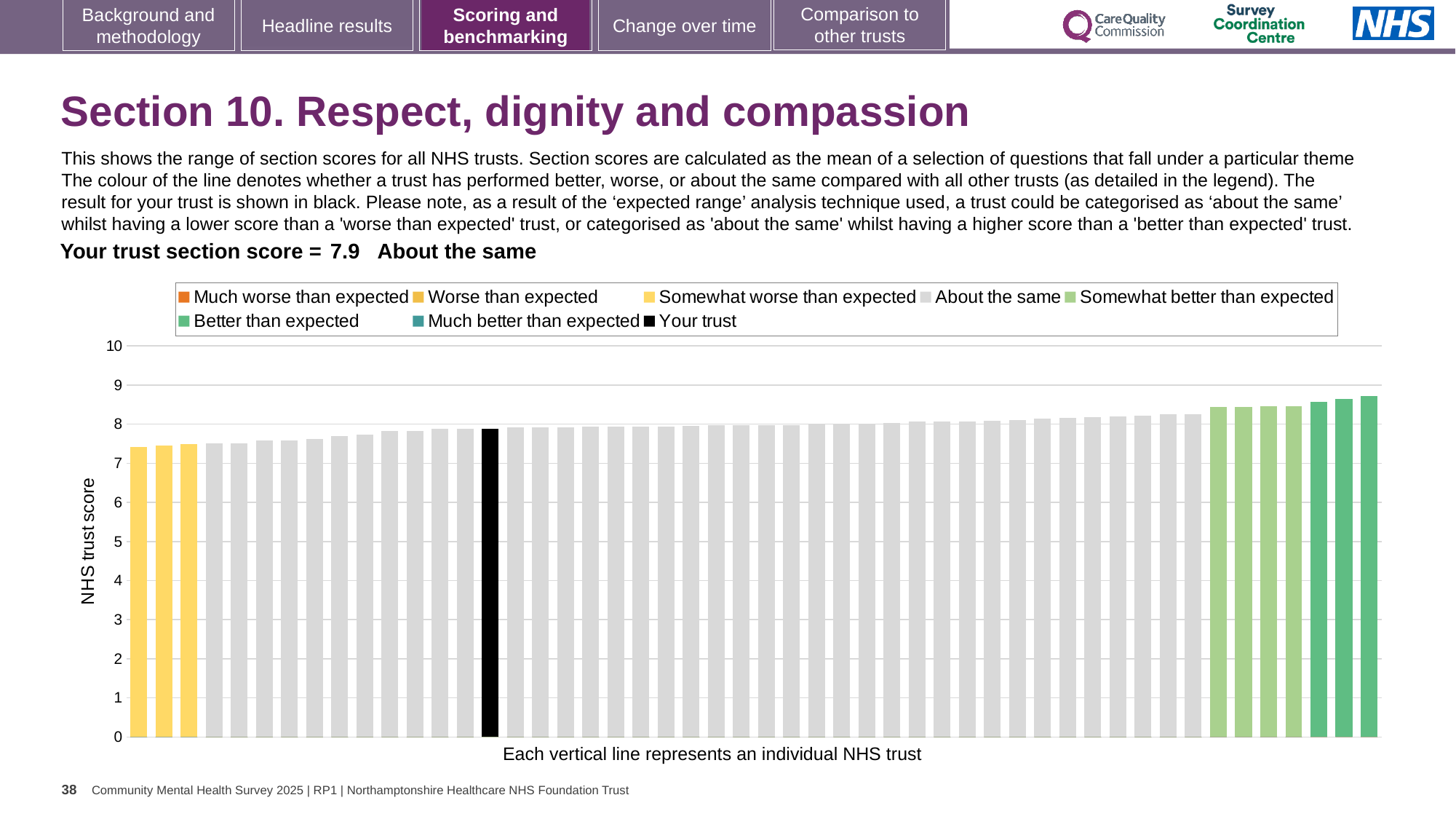
How many bars are coloured yellow ('Somewhat worse than expected')? 3 What is the section score for your trust, as printed on the slide? 7.9 What kind of chart is shown on the slide? Bar chart Do the bar values rise or fall from left to right along the x axis? Rise Which is taller: the black 'Your trust' bar or the leftmost yellow bar? The black 'Your trust' bar Is the value of the black 'Your trust' bar greater or less than 7? greater What is the label on the vertical axis of the chart? NHS trust score How many entries does the chart legend list? 8 What colour is used for the 'Your trust' bar in the chart? Black Is the value of the leftmost bar greater or less than 7? greater How many bars are coloured dark green ('Better than expected')? 3 Is the value of the tallest bar on the chart greater or less than 9? less